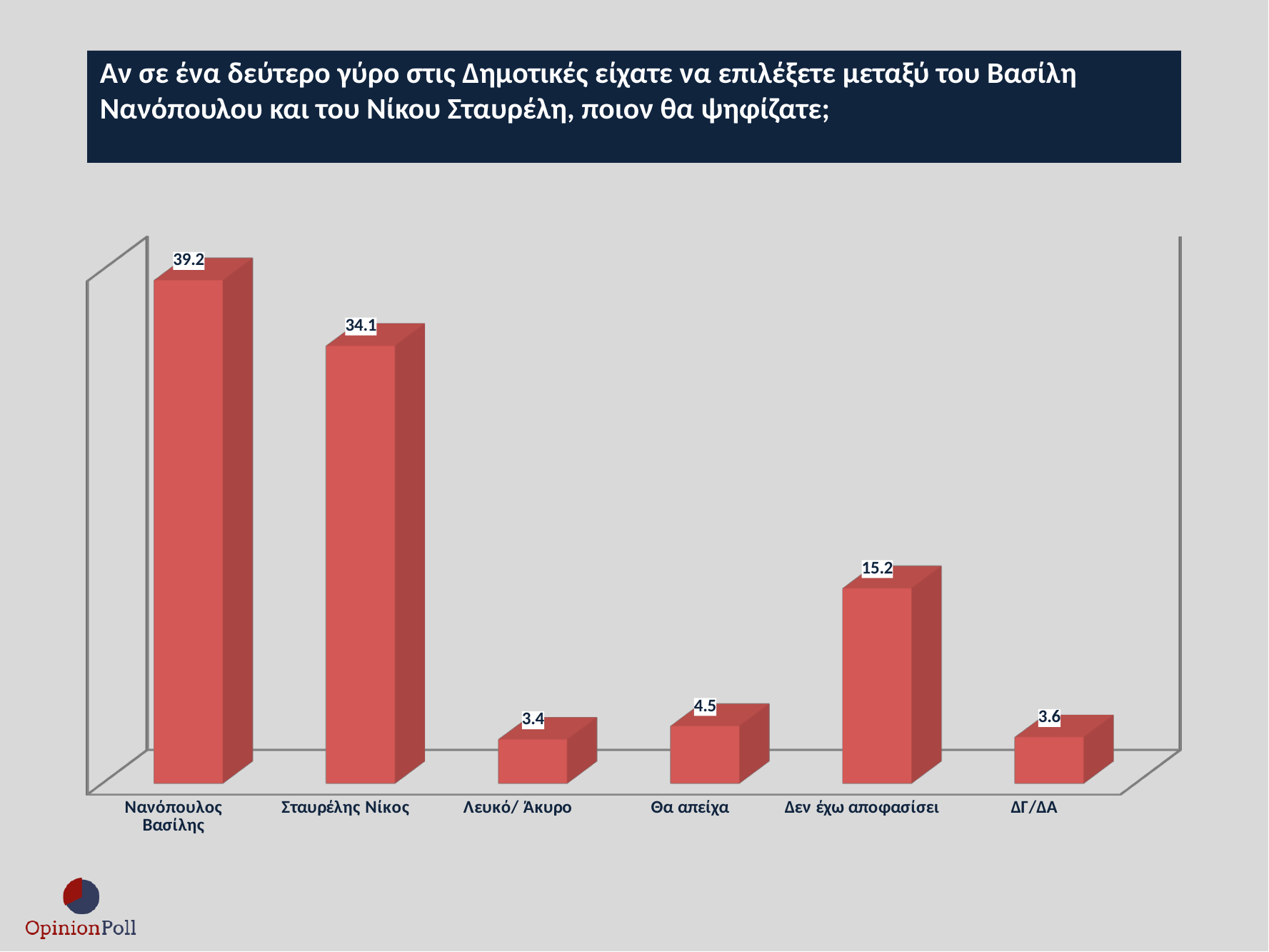
What is the value for Θα απείχα? 4.5 What is the total of the values for Λευκό/ Άκυρο and Θα απείχα? 7.9 What is the value for ΔΓ/ΔΑ? 3.6 How many categories are shown in the chart? 6 What is the value for Δεν έχω αποφασίσει? 15.2 Which is larger, the value for Θα απείχα or the value for ΔΓ/ΔΑ? Θα απείχα What is the value for Νανόπουλος Βασίλης? 39.2 What kind of chart is shown on the slide? Bar chart What is the difference between the values for Νανόπουλος Βασίλης and Σταυρέλης Νίκος? 5.1 Which category has the lowest value? Λευκό/ Άκυρο Which category has the highest value? Νανόπουλος Βασίλης What is the value for Σταυρέλης Νίκος? 34.1